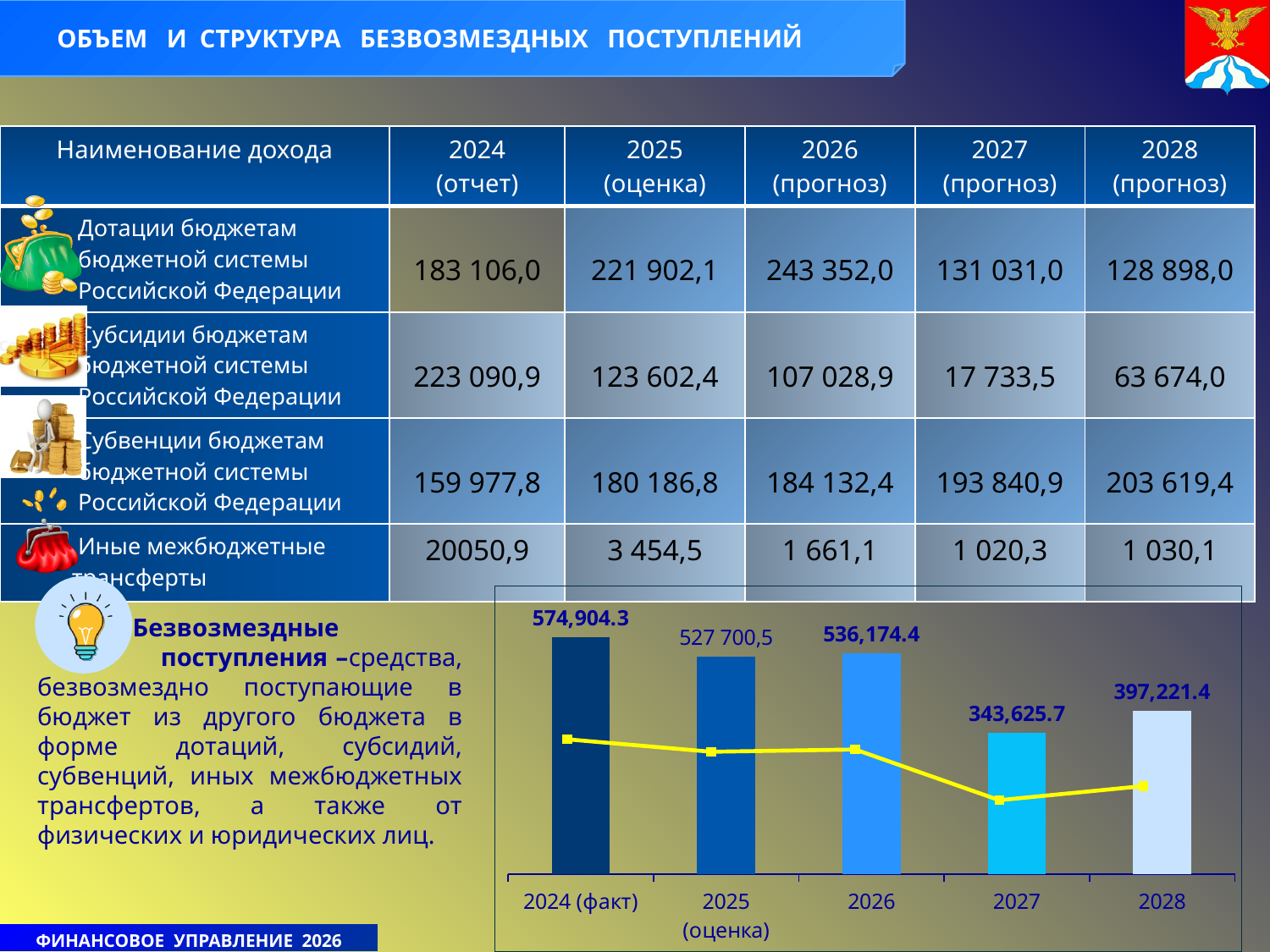
What is the value shown for 2027 in the bar chart? 343,625.7 What is the value shown for 2024 (факт) in the bar chart? 574,904.3 In the bar chart, what is the difference between the value for 2026 and the value for 2027? 192,548.7 In the bar chart, which is larger: the value for 2026 or the value for 2027? 2026 What is the value shown for 2025 (оценка) in the bar chart? 527 700,5 What kind of chart is shown at the bottom right of the slide? Bar chart with a line overlay Which year has the highest value in the bar chart? 2024 (факт) Which year has the lowest value in the bar chart? 2027 How many years (categories) are shown in the bar chart? 5 What is the value shown for 2026 in the bar chart? 536,174.4 Do the bar values rise or fall from 2024 (факт) to 2027 in the bar chart? Fall What is the value shown for 2028 in the bar chart? 397,221.4